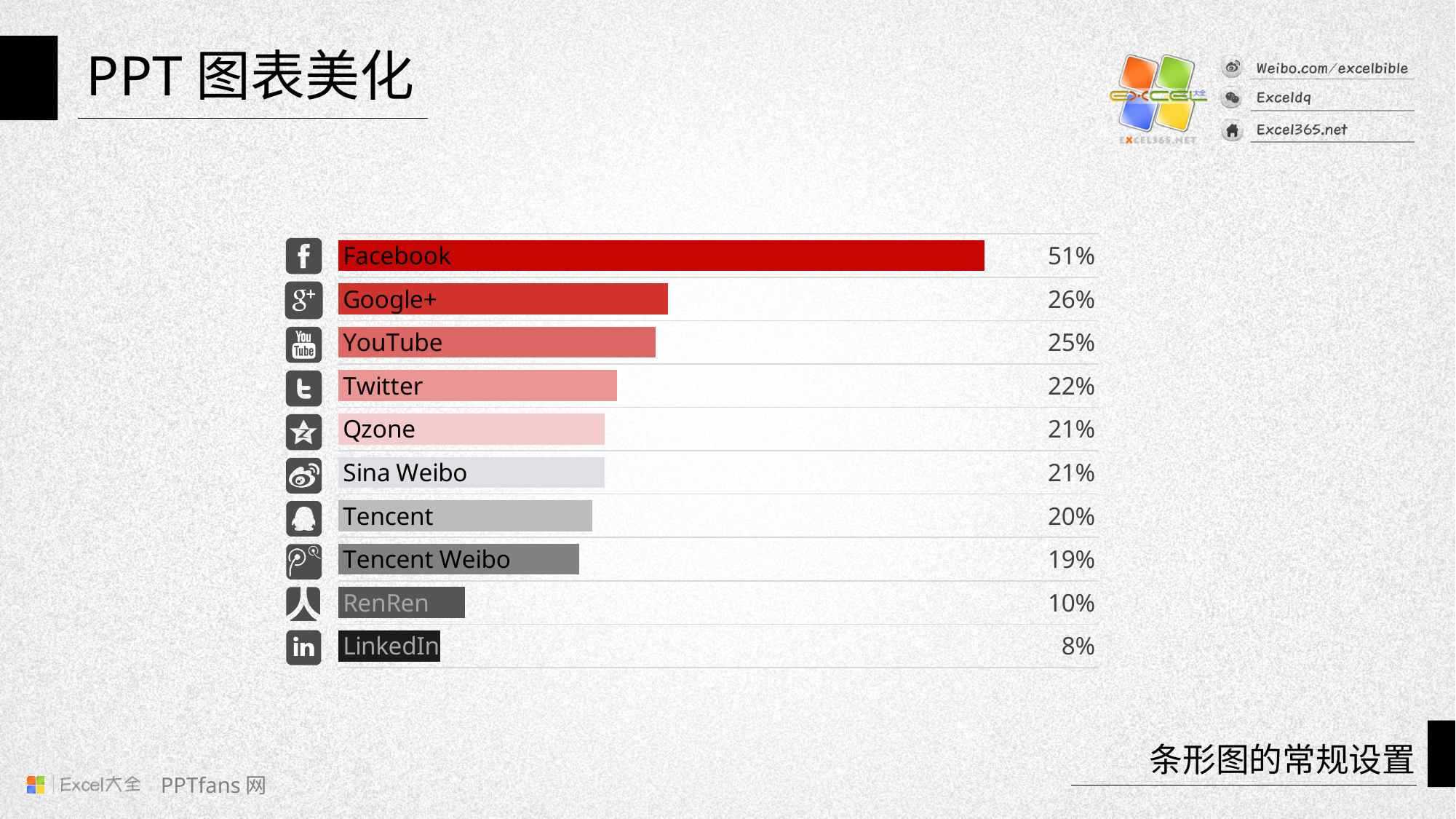
Which is larger, the value for YouTube or the value for Tencent? YouTube How many categories are shown in the chart? 10 What is the value for Facebook? 51% What is the difference between the values for Facebook and Google+? 25% Which category has the lowest value? LinkedIn What kind of chart is shown on the slide? Bar chart What is the value for Twitter? 22% What is the value for Tencent Weibo? 19% Which category has the highest value? Facebook What is the value for LinkedIn? 8% Which two categories share the same value of 21%? Qzone and Sina Weibo What is the difference between the values for RenRen and LinkedIn? 2%